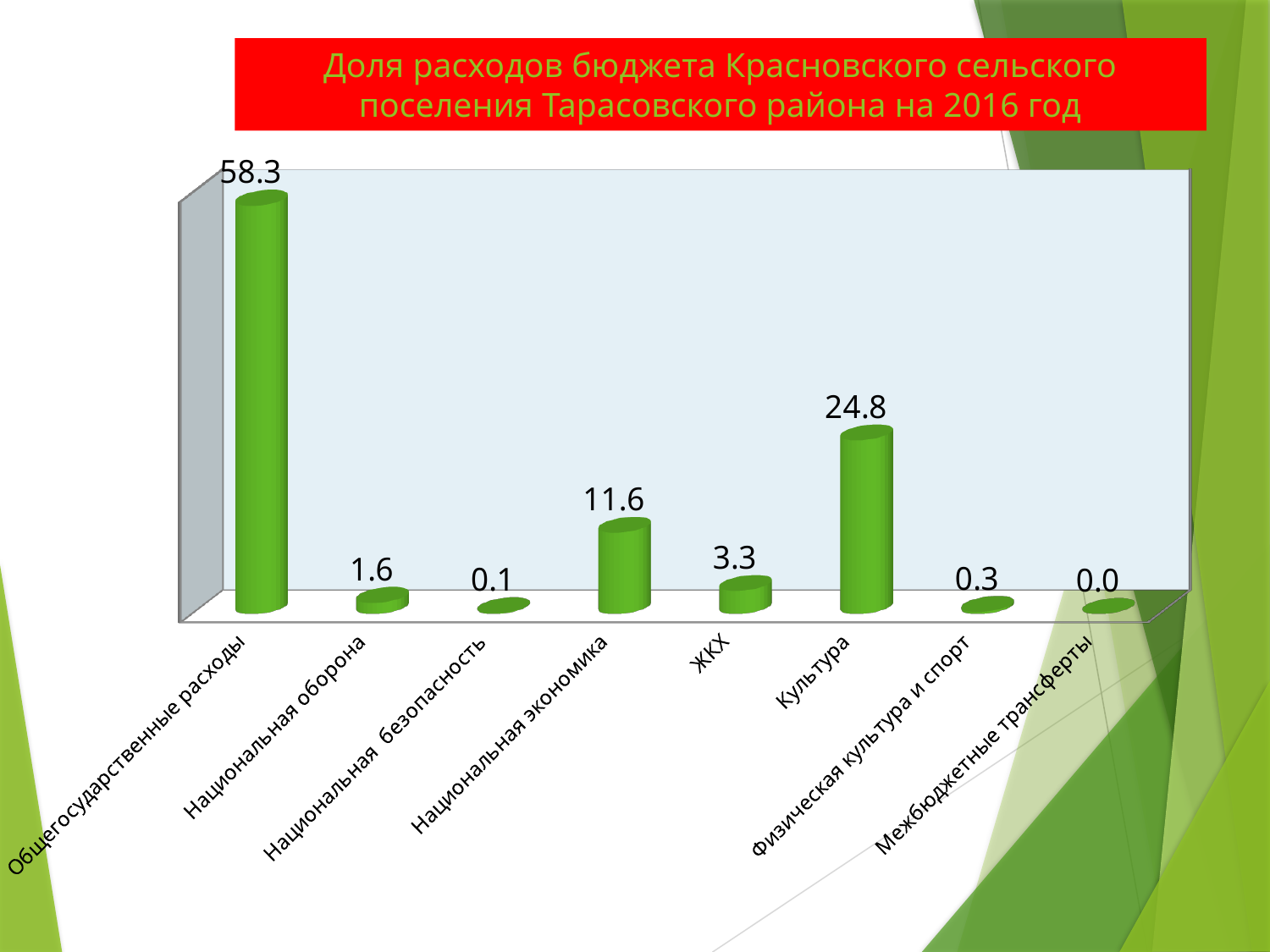
What is the difference between the values for Общегосударственные расходы and Культура? 33.5 What is the value for Национальная экономика? 11.6 Which category has the lowest value? Межбюджетные трансферты What is the value for Культура? 24.8 What is the value for Общегосударственные расходы? 58.3 Which category has the highest value? Общегосударственные расходы How many categories are shown in the chart? 8 What is the value for Физическая культура и спорт? 0.3 Which is larger, the value for Национальная экономика or the value for ЖКХ? Национальная экономика What is the title of the chart? Доля расходов бюджета Красновского сельского поселения Тарасовского района на 2016 год What is the value for ЖКХ? 3.3 What kind of chart is shown on the slide? Bar chart